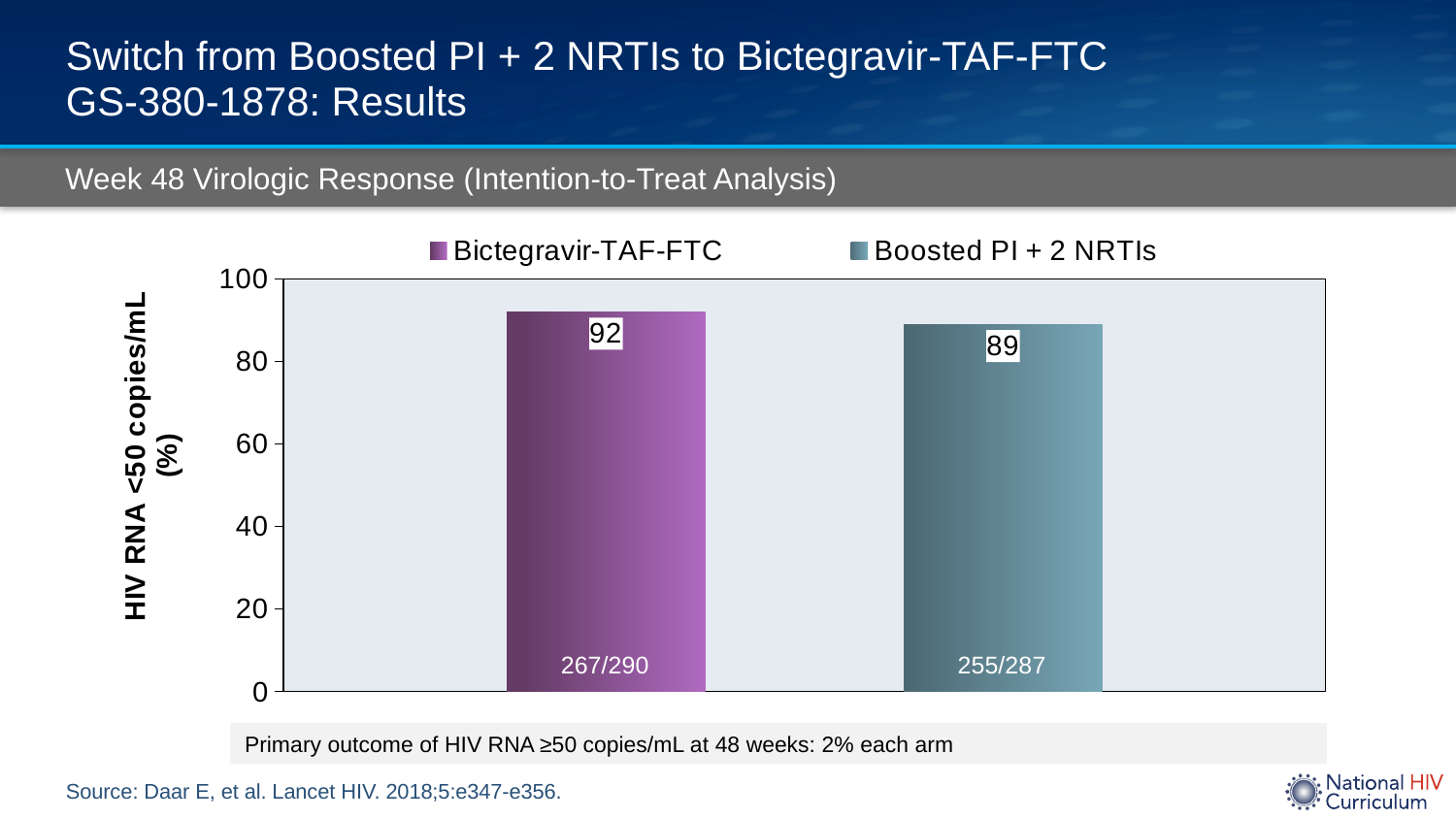
Is the value for Boosted PI + 2 NRTIs greater or less than 80? greater What fraction is printed inside the Boosted PI + 2 NRTIs bar? 255/287 What is the value for Boosted PI + 2 NRTIs? 89 What is the value for Bictegravir-TAF-FTC? 92 What kind of chart is shown? bar chart Which series has the higher value? Bictegravir-TAF-FTC What is the label of the y axis? HIV RNA <50 copies/mL (%) What is the difference between the Bictegravir-TAF-FTC value and the Boosted PI + 2 NRTIs value? 3 Is the value for Bictegravir-TAF-FTC larger or smaller than the value for Boosted PI + 2 NRTIs? larger What fraction is printed inside the Bictegravir-TAF-FTC bar? 267/290 Which series has the lower value? Boosted PI + 2 NRTIs How many series does the legend list? 2